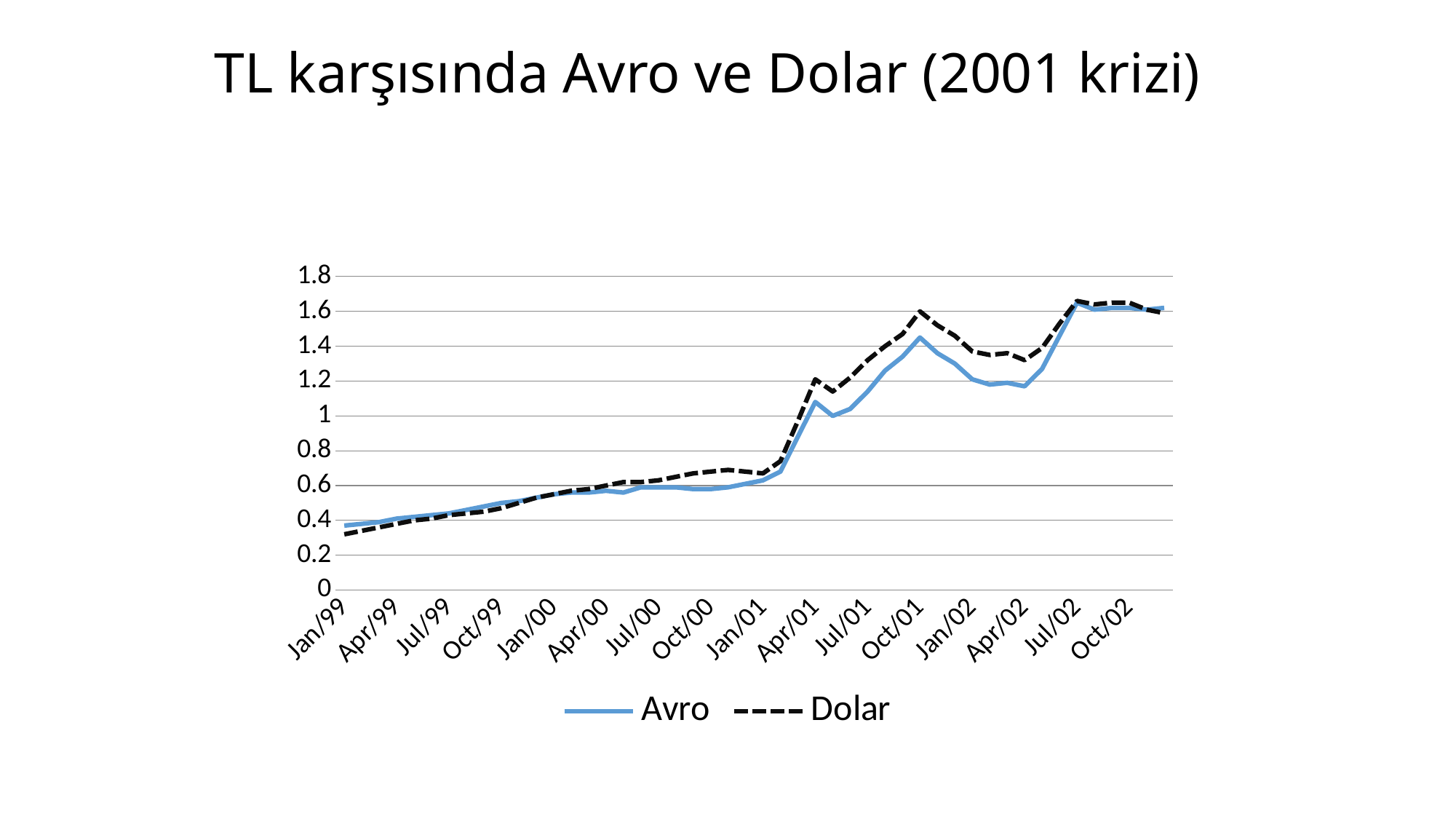
Is the value for Avro at Jul/02 greater or less than 1.4? greater How many series does the legend list? 2 What is the title of the chart? TL karşısında Avro ve Dolar (2001 krizi) How many month labels are shown on the x axis? 16 Is the value for Dolar at Jan/99 greater or less than 0.4? less Which series is drawn with a dashed line? Dolar Overall, do the Avro and Dolar values rise or fall from Jan/99 to Oct/02? rise Is the value for Avro at Apr/02 greater or less than 1.4? less Does the Avro value rise or fall between Oct/01 and Apr/02? fall At Jan/99, which series has the higher value, Avro or Dolar? Avro What kind of chart is shown on the slide? line chart At Oct/01, which series has the higher value, Avro or Dolar? Dolar